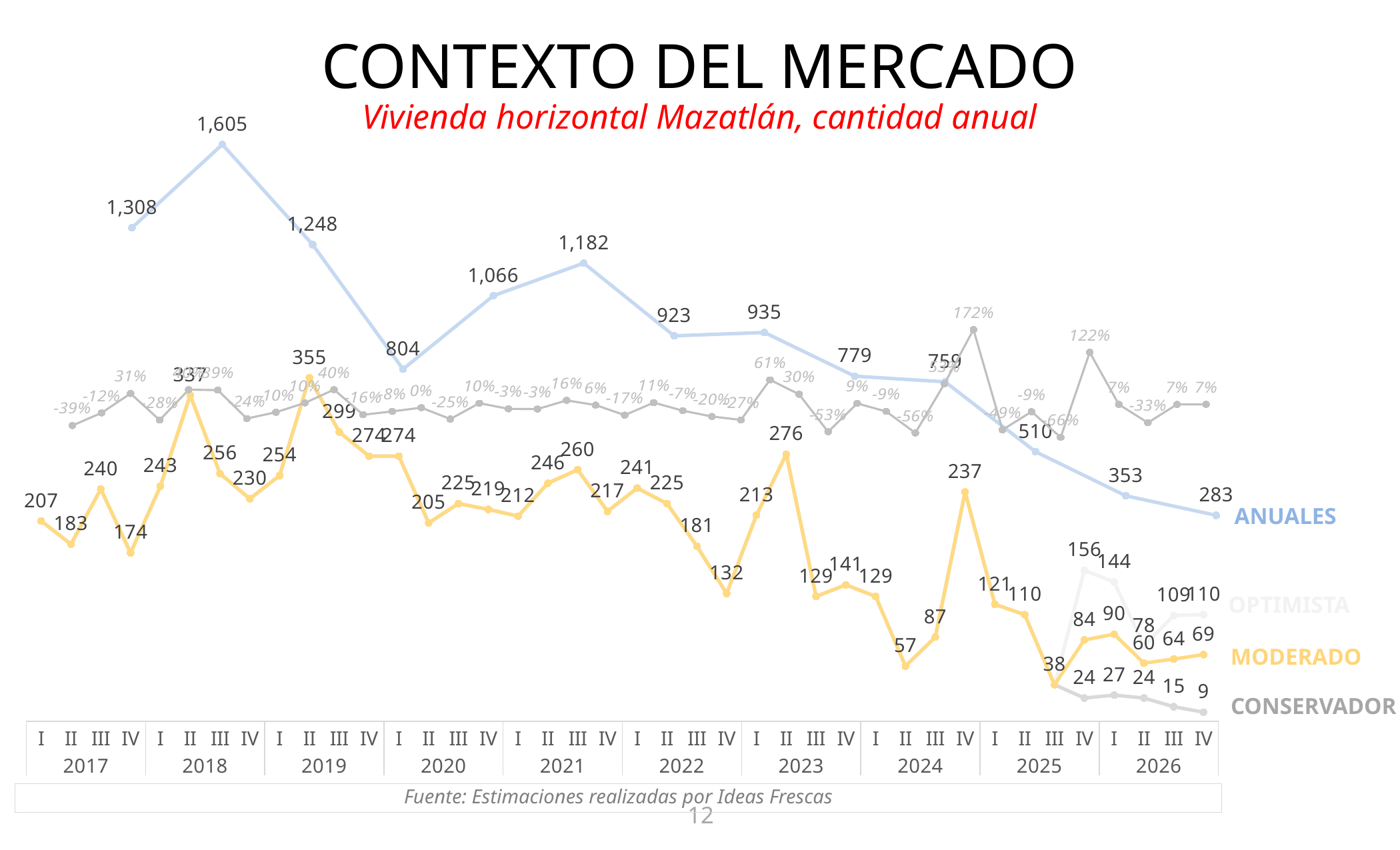
How many years are shown on the x axis? 10 What is the MODERADO value for quarter IV of 2024? 237 What kind of chart is shown on the slide? line chart What is the CONSERVADOR value for quarter IV of 2025? 24 What is the highest value on the MODERADO line? 355 What is the subtitle of the chart shown in red? Vivienda horizontal Mazatlán, cantidad anual What is the difference between the first two ANUALES values, 1,605 and 1,308? 297 What is the lowest value on the CONSERVADOR line? 9 What is the MODERADO value for quarter I of 2017? 207 Which is larger on the MODERADO line: quarter II of 2023 or quarter IV of 2024? quarter II of 2023 What is the lowest value on the ANUALES line? 283 What is the highest value on the ANUALES line? 1,605